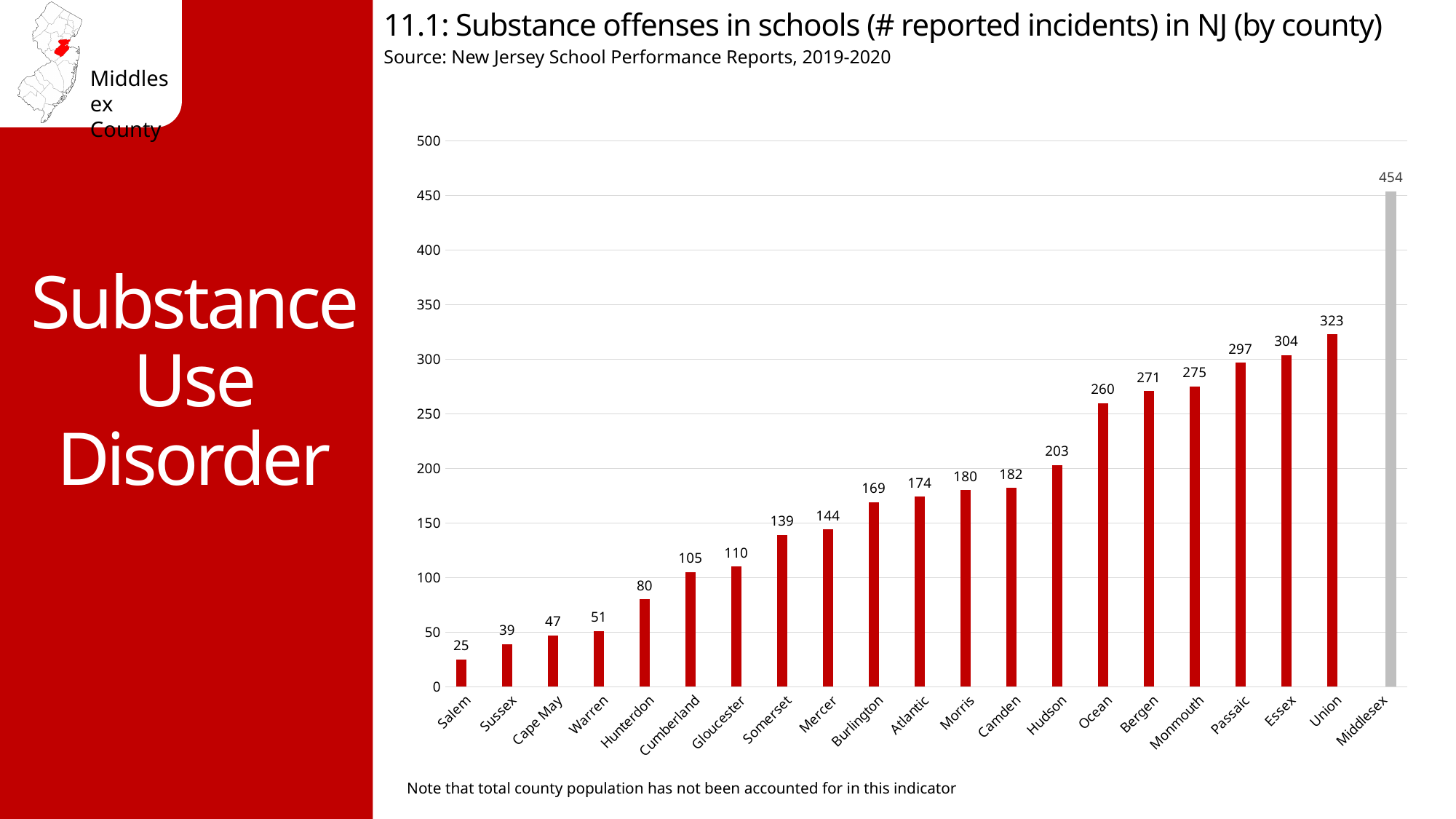
Do the values rise or fall moving from left to right along the x axis? Rise Which county has the lowest number of reported substance offenses in schools? Salem Is the value for Passaic greater or less than 250? greater What value is shown for Bergen? 271 Which has a higher value, Ocean or Monmouth? Monmouth What is the number of reported substance offenses in schools for Hunterdon? 80 What kind of chart is shown on the slide? Bar chart How many substance offenses in schools were reported for Middlesex County? 454 How many counties are shown on the x axis of the chart? 21 What is the difference between the values for Hudson and Camden? 21 Which county has the highest number of reported substance offenses in schools? Middlesex What is the difference between the values for Middlesex and Union? 131